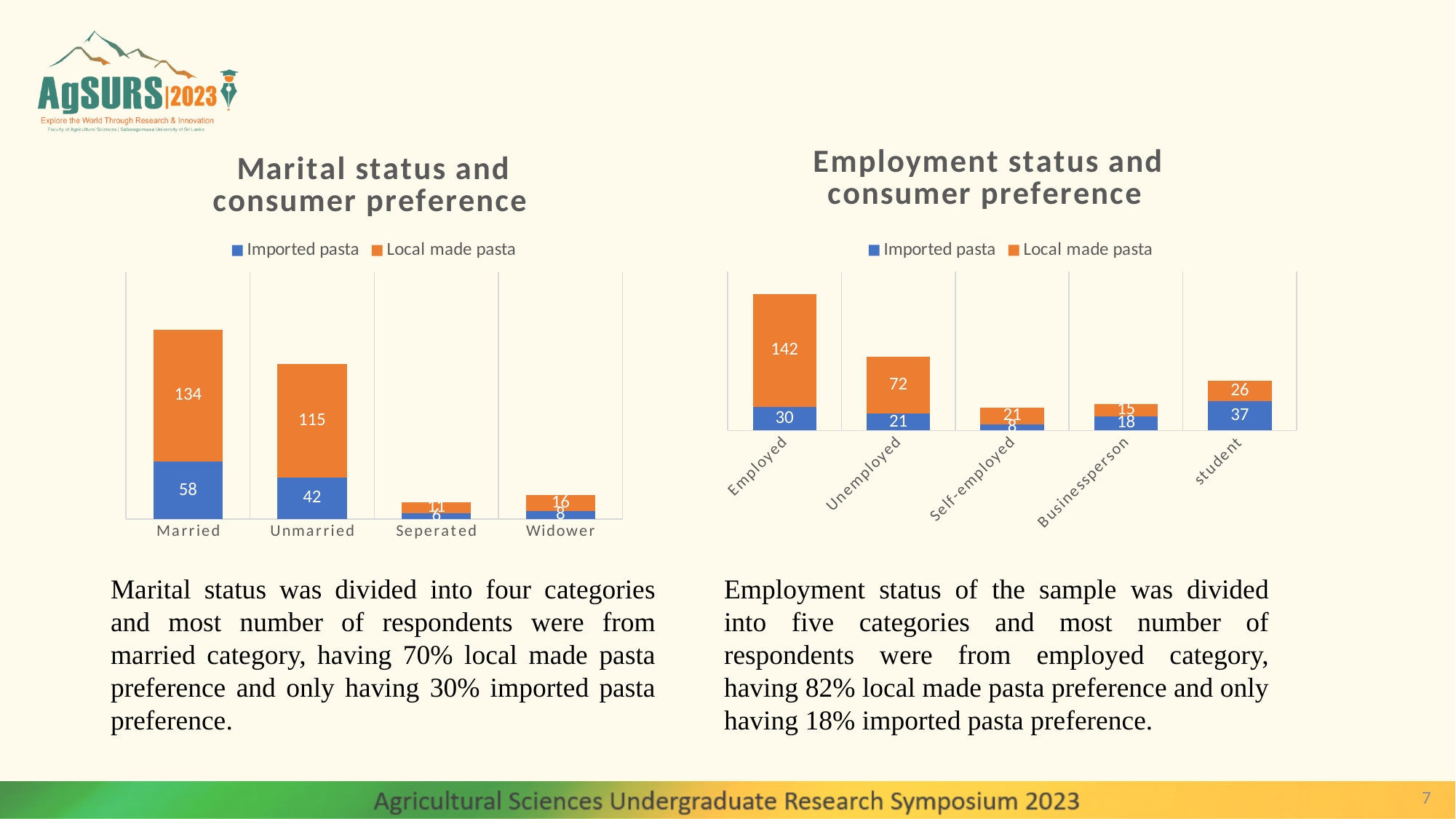
In the 'Marital status and consumer preference' chart, what is the difference between the Local made pasta and Imported pasta values for Married? 76 How many categories are shown in the 'Marital status and consumer preference' chart? 4 In the 'Employment status and consumer preference' chart, what is the Local made pasta value for Employed? 142 In the 'Marital status and consumer preference' chart, which category has the highest Local made pasta value? Married How many series does the legend list in the 'Employment status and consumer preference' chart? 2 In the 'Employment status and consumer preference' chart, is the Imported pasta value larger for Unemployed or for student? student In the 'Marital status and consumer preference' chart, what is the Local made pasta value for Married? 134 What type of chart is the 'Employment status and consumer preference' chart? Stacked bar chart In the 'Marital status and consumer preference' chart, what is the total of the stacked bar for Unmarried? 157 In the 'Employment status and consumer preference' chart, which category has the lowest Imported pasta value? Self-employed In the 'Employment status and consumer preference' chart, what is the Imported pasta value for student? 37 In the 'Marital status and consumer preference' chart, what is the Imported pasta value for Unmarried? 42